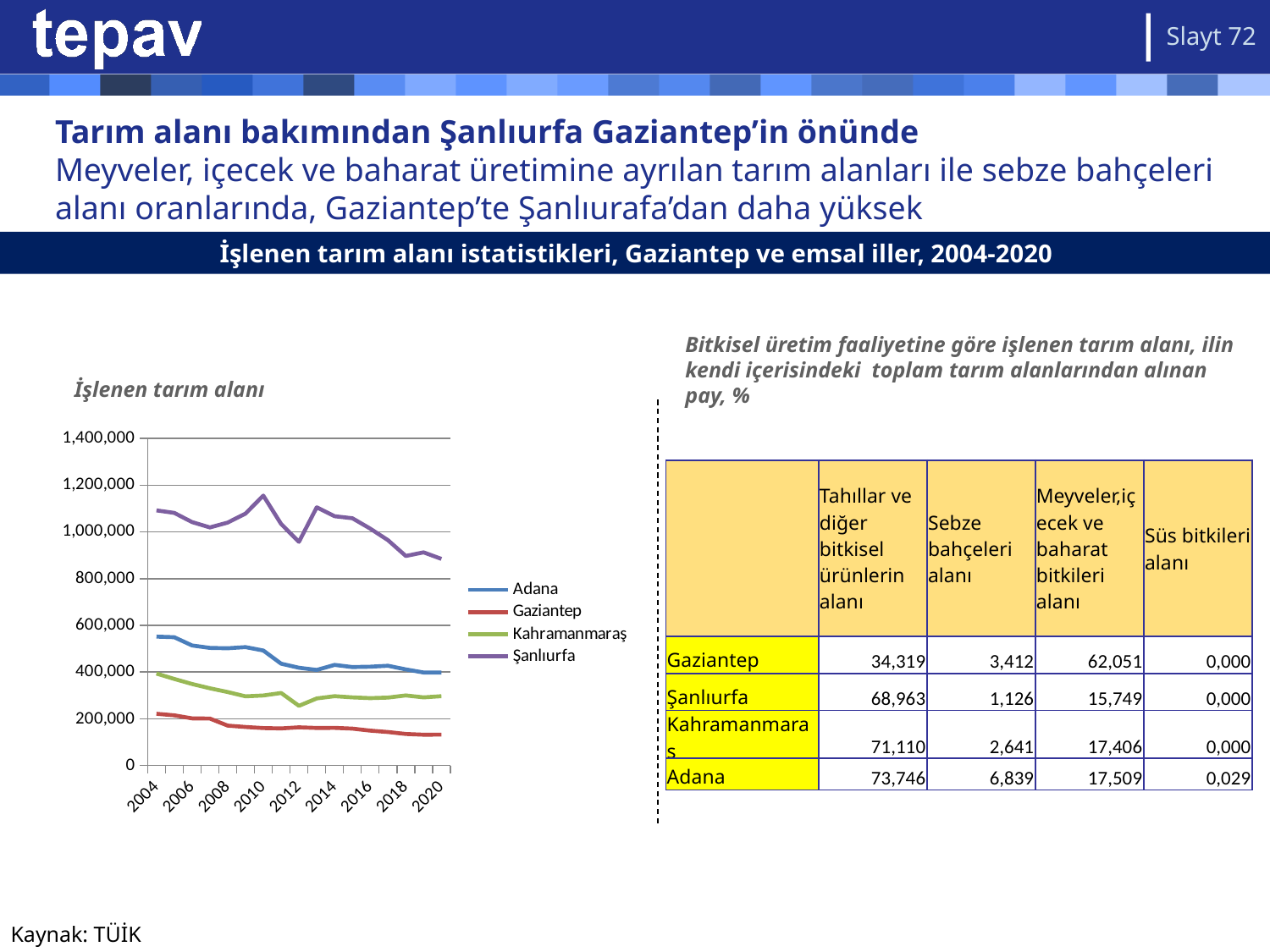
In the 'İşlenen tarım alanı' chart, is the value for Şanlıurfa in 2020 greater or less than 1,000,000? less What is the first and last year shown on the x axis of the 'İşlenen tarım alanı' chart? 2004 and 2020 In the 'İşlenen tarım alanı' chart, does the Gaziantep line rise or fall from 2004 to 2020? fall In the 'İşlenen tarım alanı' chart, which series has the lowest values across the whole period? Gaziantep Which series are listed in the legend of the 'İşlenen tarım alanı' chart? Adana, Gaziantep, Kahramanmaraş, Şanlıurfa What kind of chart is the 'İşlenen tarım alanı' chart? line chart In the 'İşlenen tarım alanı' chart, is the value for Gaziantep in 2020 greater or less than 200,000? less In the 'İşlenen tarım alanı' chart, is the value for Adana in 2004 greater or less than 400,000? greater How many series does the legend of the 'İşlenen tarım alanı' chart list? 4 In the 'İşlenen tarım alanı' chart, which is larger in 2010: Adana or Kahramanmaraş? Adana In the 'İşlenen tarım alanı' chart, which series has the highest values across the whole period? Şanlıurfa